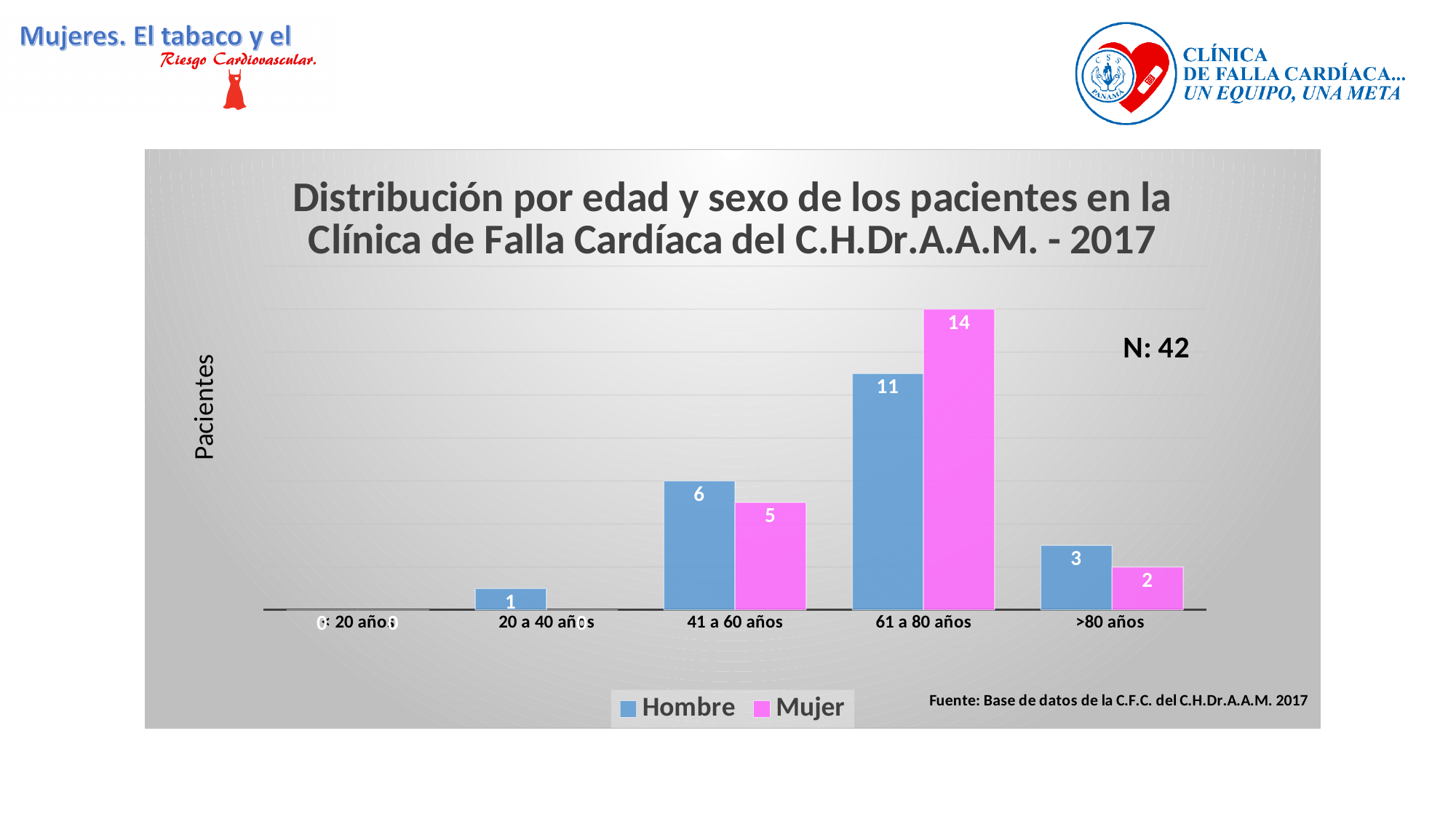
What is the value for Mujer in the 61 a 80 años category? 14 How many age categories are shown on the x axis? 5 Which age category has the highest value for Mujer? 61 a 80 años In the 41 a 60 años category, which is larger, Hombre or Mujer? Hombre What is the difference between the Mujer and Hombre values in the 61 a 80 años category? 3 What are the two series named in the legend? Hombre and Mujer What is the total N stated on the chart? 42 What type of chart is shown on the slide? bar chart What is the value for Mujer in the >80 años category? 2 How many series does the legend list? 2 What is the value for Hombre in the 41 a 60 años category? 6 What is the value for Hombre in the 61 a 80 años category? 11